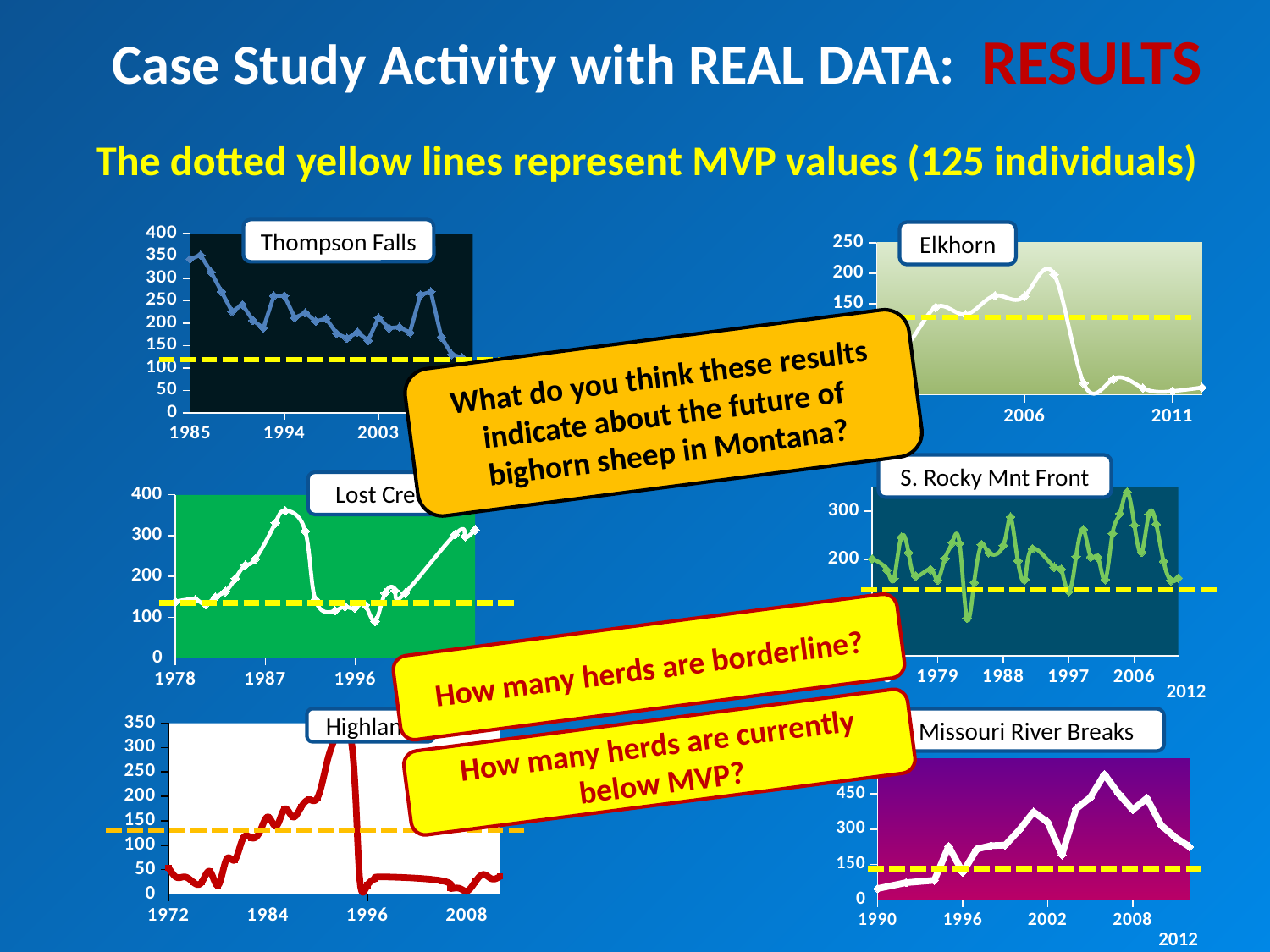
What kind of chart is the Thompson Falls chart? line chart In the Highlands chart, is the value for 1972 greater or less than 100? less According to the slide, what do the dotted yellow lines represent? MVP values (125 individuals) In the Thompson Falls chart, is the value for 1985 greater or less than 300? greater In the Missouri River Breaks chart, do the values generally rise or fall between 1990 and 2006? rise How many charts are shown on the slide? 6 In the Missouri River Breaks chart, is the value for 1990 greater or less than 150? less In the Thompson Falls chart, do the values generally rise or fall from 1985 onward? fall